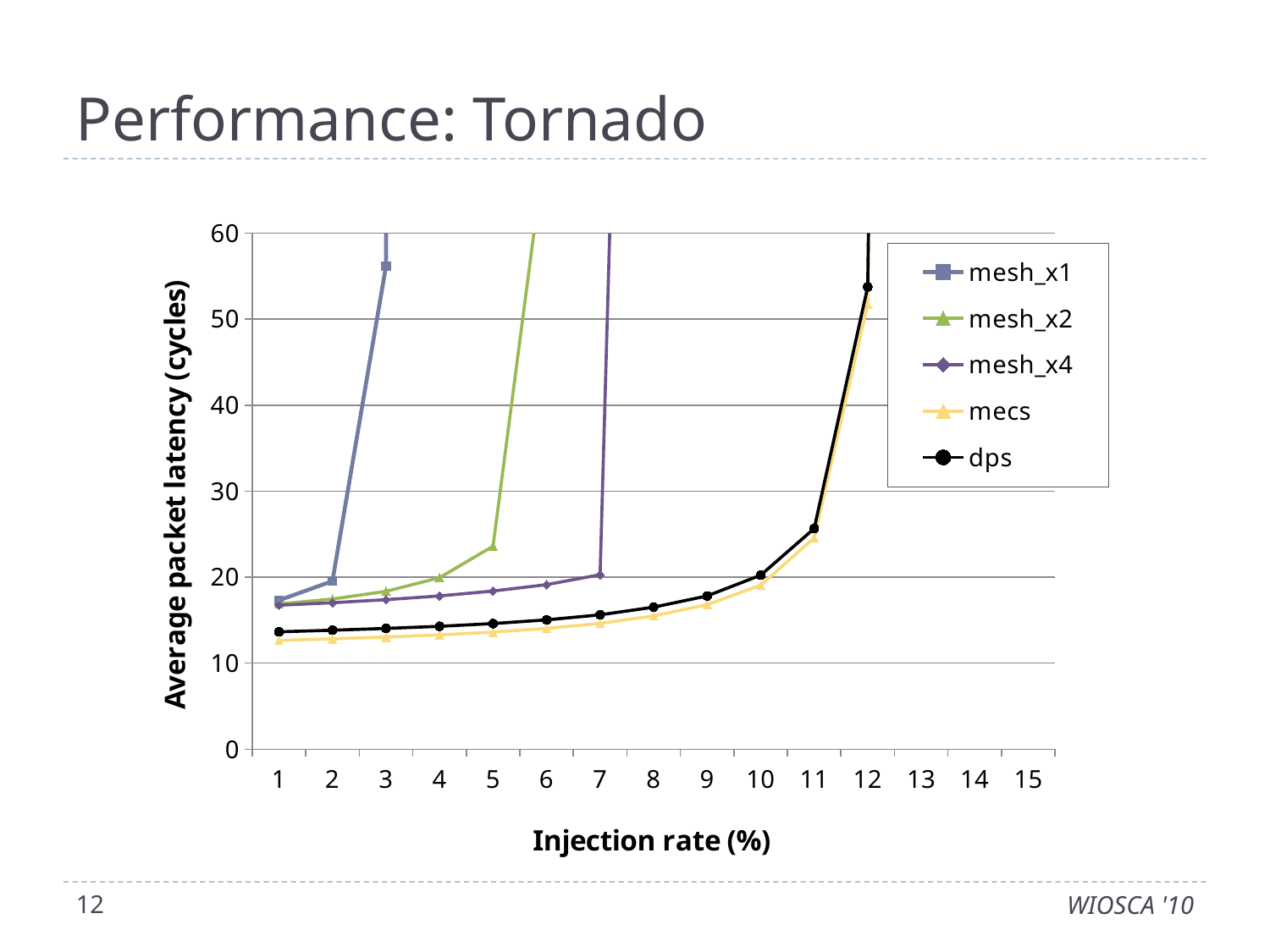
Is the value for dps at injection rate 12 greater or less than 50? greater Is the value for mesh_x2 at injection rate 5 greater or less than 20? greater Is the value for dps at injection rate 11 greater or less than 20? greater At injection rate 5, which has the higher average packet latency, mesh_x2 or dps? mesh_x2 What is the title of the slide containing the chart? Performance: Tornado Which series has the lowest average packet latency at injection rate 1? mecs What is the label of the y axis? Average packet latency (cycles) How many series does the legend list? 5 Does the average packet latency for dps rise or fall as the injection rate increases? rise What kind of chart is shown on the slide? line chart